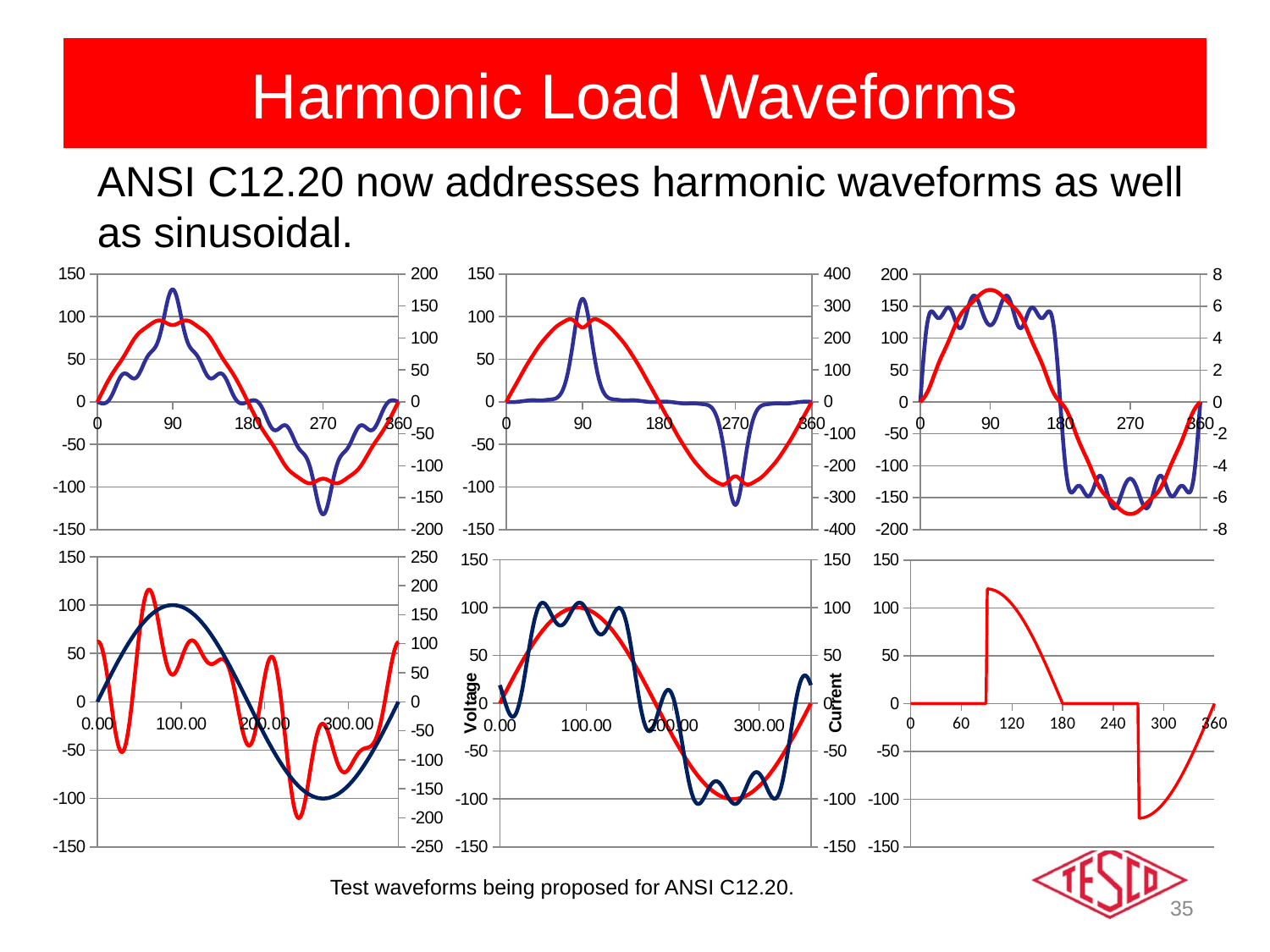
In the bottom-right chart, is the peak value of the red line greater or less than 100? greater How many charts are shown on the slide? 6 In the bottom-right chart, is the lowest value of the red line greater or less than -100? less In the top-middle chart, is the peak of the red line on the left axis greater or less than 50? greater In the bottom-right chart, what is the value of the red line at x = 0? 0 How many lines are plotted in the bottom-right chart? 1 In the bottom-middle chart, what is the label on the left vertical axis? Voltage How many lines are plotted in the bottom-left chart? 2 In the bottom-right chart, what is the value of the red line at x = 240? 0 In the bottom-middle chart, what is the label on the right vertical axis? Current What kind of chart is the top-left chart on the slide? line chart